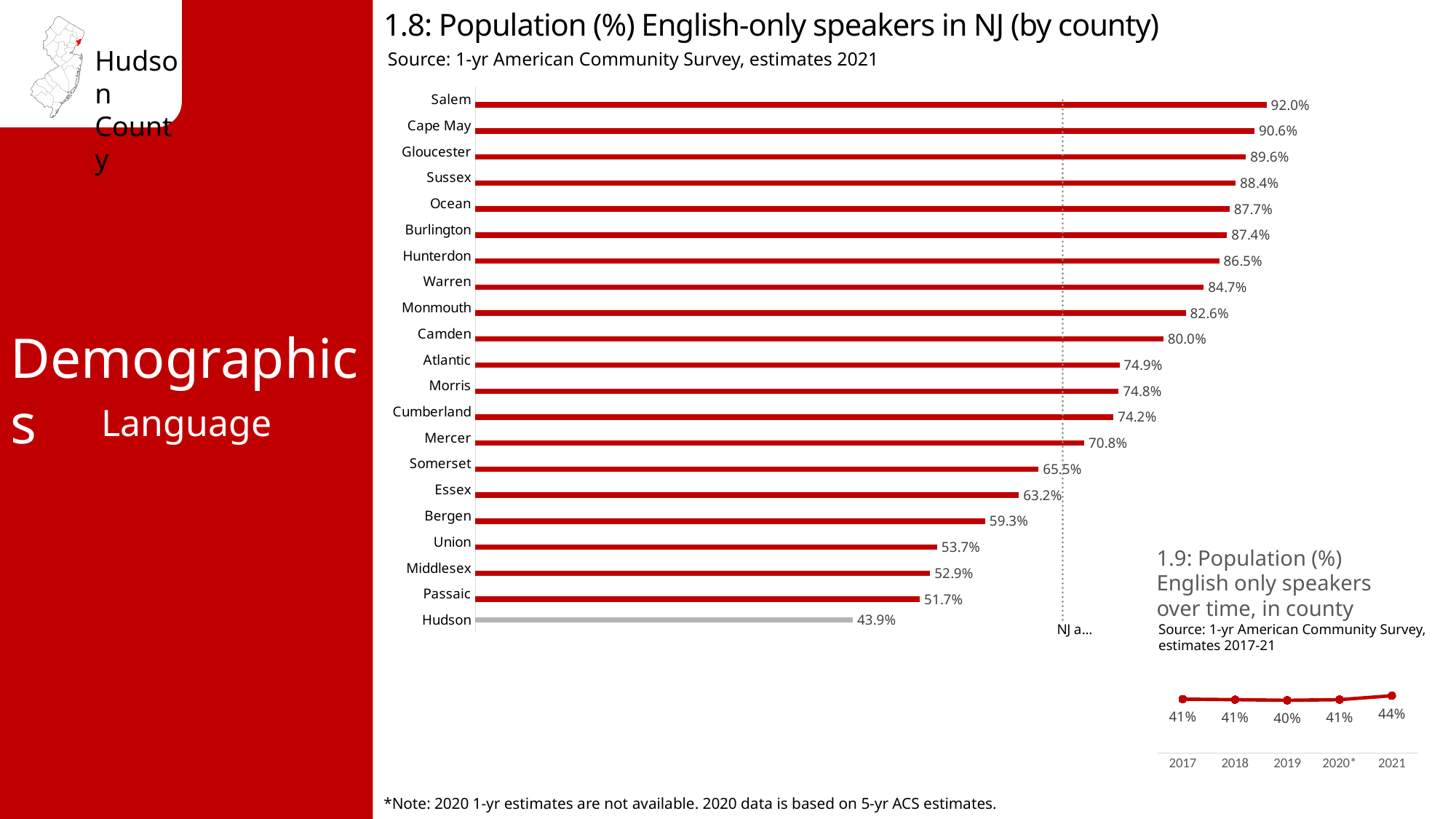
In chart 1.8, how many counties are shown? 21 What kind of chart is chart 1.9? Line chart In chart 1.8, which county has the highest value? Salem In chart 1.8, which is larger, the value for Bergen or the value for Passaic? Bergen In chart 1.9, what is the value for 2021? 44% In chart 1.8, what is the value for Hudson? 43.9% In chart 1.9, which year has the lowest value? 2019 What kind of chart is chart 1.8? Bar chart In chart 1.8, what is the difference between Salem and Hudson? 48.1% In chart 1.8, which county has the lowest value? Hudson In chart 1.9, how many data points are plotted? 5 In chart 1.8, what is the value for Camden? 80.0%